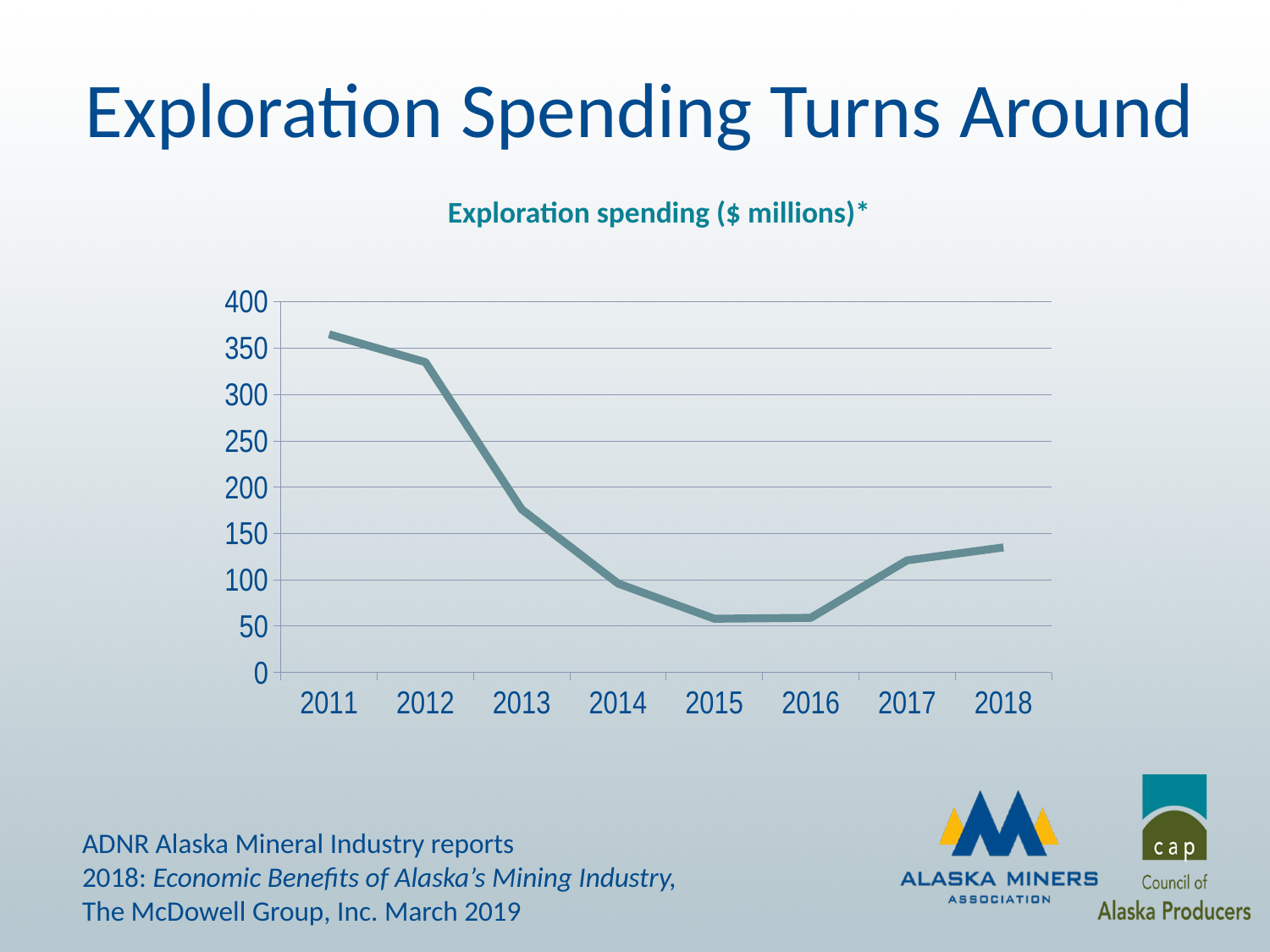
Which is larger, the value for 2013 or the value for 2014? 2013 Which is larger, the value for 2011 or the value for 2018? 2011 Is the value for 2012 greater or less than 300? greater Is the value for 2013 greater or less than 200? less Is the value for 2011 greater or less than 350? greater What kind of chart is shown on the slide? line chart How many years are plotted on the x axis of the chart? 8 What is the title of the chart? Exploration spending ($ millions)* Does exploration spending rise or fall from 2011 to 2015? fall Which year has the highest exploration spending? 2011